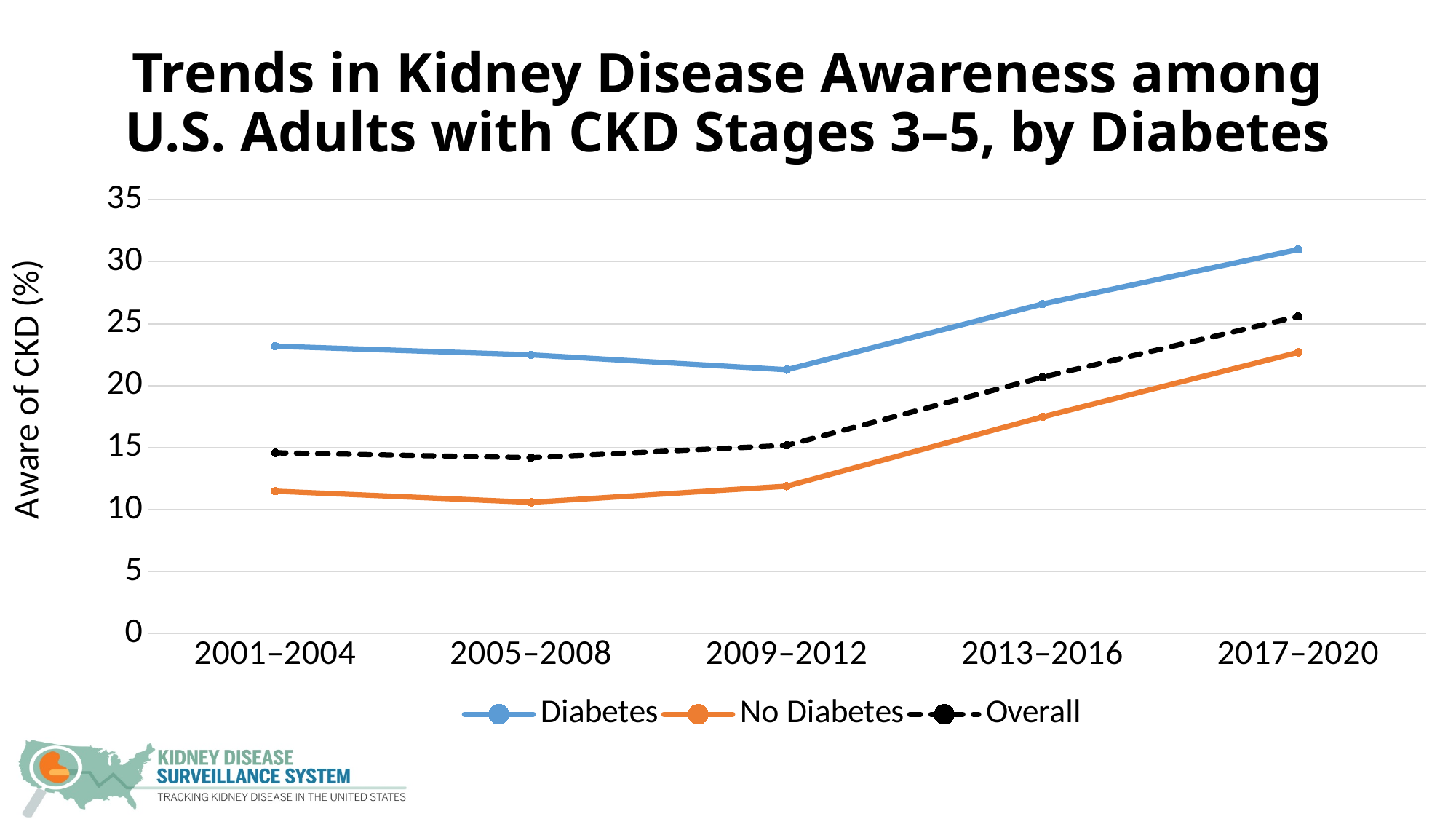
How many time periods are shown on the x axis? 5 Is the value for No Diabetes in 2017–2020 greater or less than 25? less In which period is the Diabetes series highest? 2017–2020 In which period is the No Diabetes series lowest? 2005–2008 What kind of chart is shown on the slide? Line chart Which series is larger in 2013–2016, Diabetes or No Diabetes? Diabetes Is the value for Diabetes in 2017–2020 greater or less than 30? greater How many series does the legend list? 3 Between 2009–2012 and 2017–2020, does the No Diabetes line rise or fall? rise In which period is the Diabetes series lowest? 2009–2012 What is the label of the y axis? Aware of CKD (%)